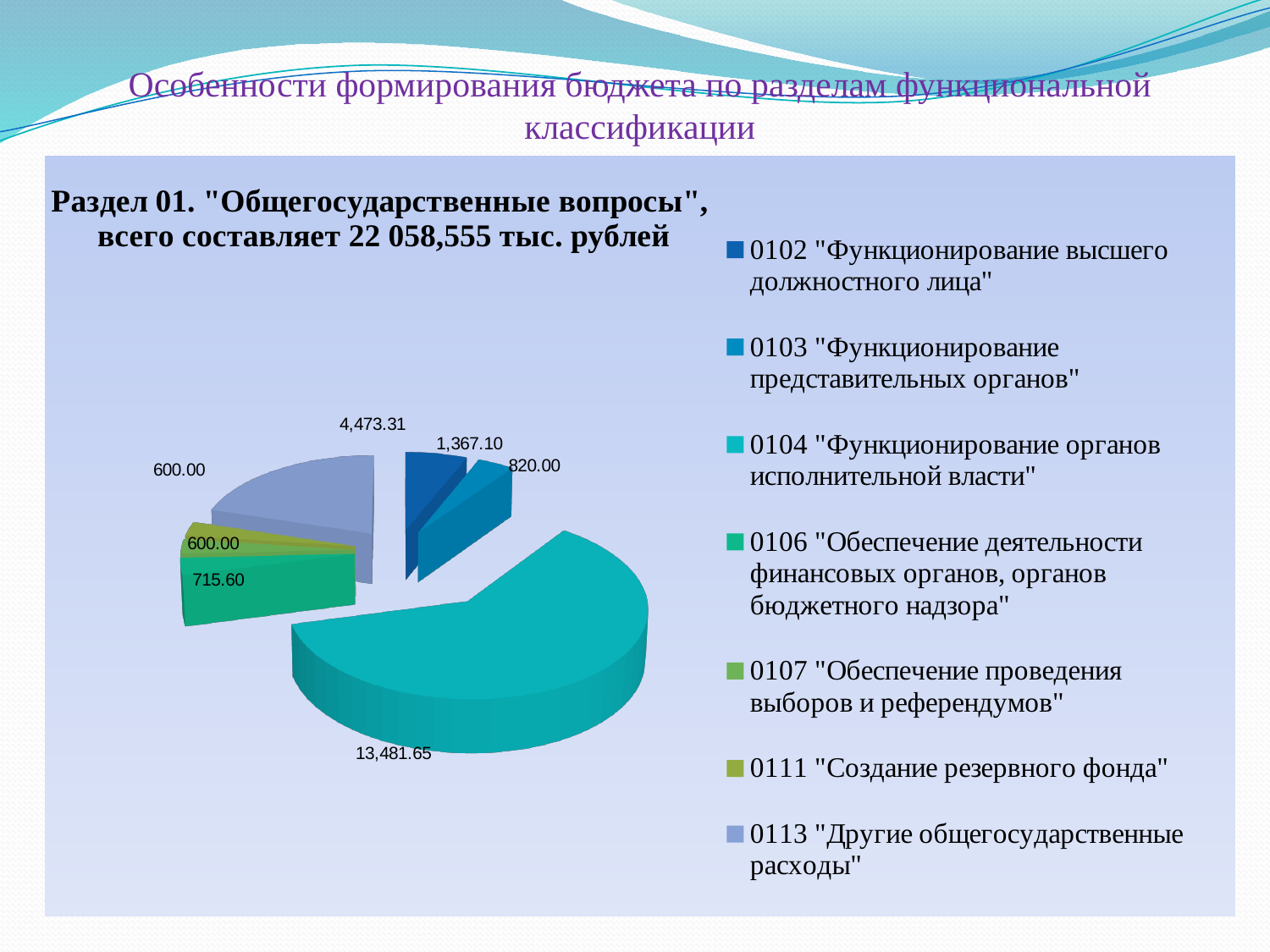
What is the value for 0113 "Другие общегосударственные расходы"? 4,473.31 What is the difference between the values for 0113 and 0102? 3,106.21 What is the value for 0102 "Функционирование высшего должностного лица"? 1,367.10 Which category has the largest slice of the pie? 0104 "Функционирование органов исполнительной власти" Which is larger: the value for 0103 or the value for 0106? 0103 What kind of chart is shown on the slide? pie chart What is the value for 0107 "Обеспечение проведения выборов и референдумов"? 600.00 What is the value for 0106 "Обеспечение деятельности финансовых органов, органов бюджетного надзора"? 715.60 According to the chart title, what is the total for Раздел 01 "Общегосударственные вопросы"? 22 058,555 тыс. рублей How many slices does the pie chart have? 7 What is the difference between the values for 0102 and 0103? 547.10 What is the value for 0104 "Функционирование органов исполнительной власти"? 13,481.65